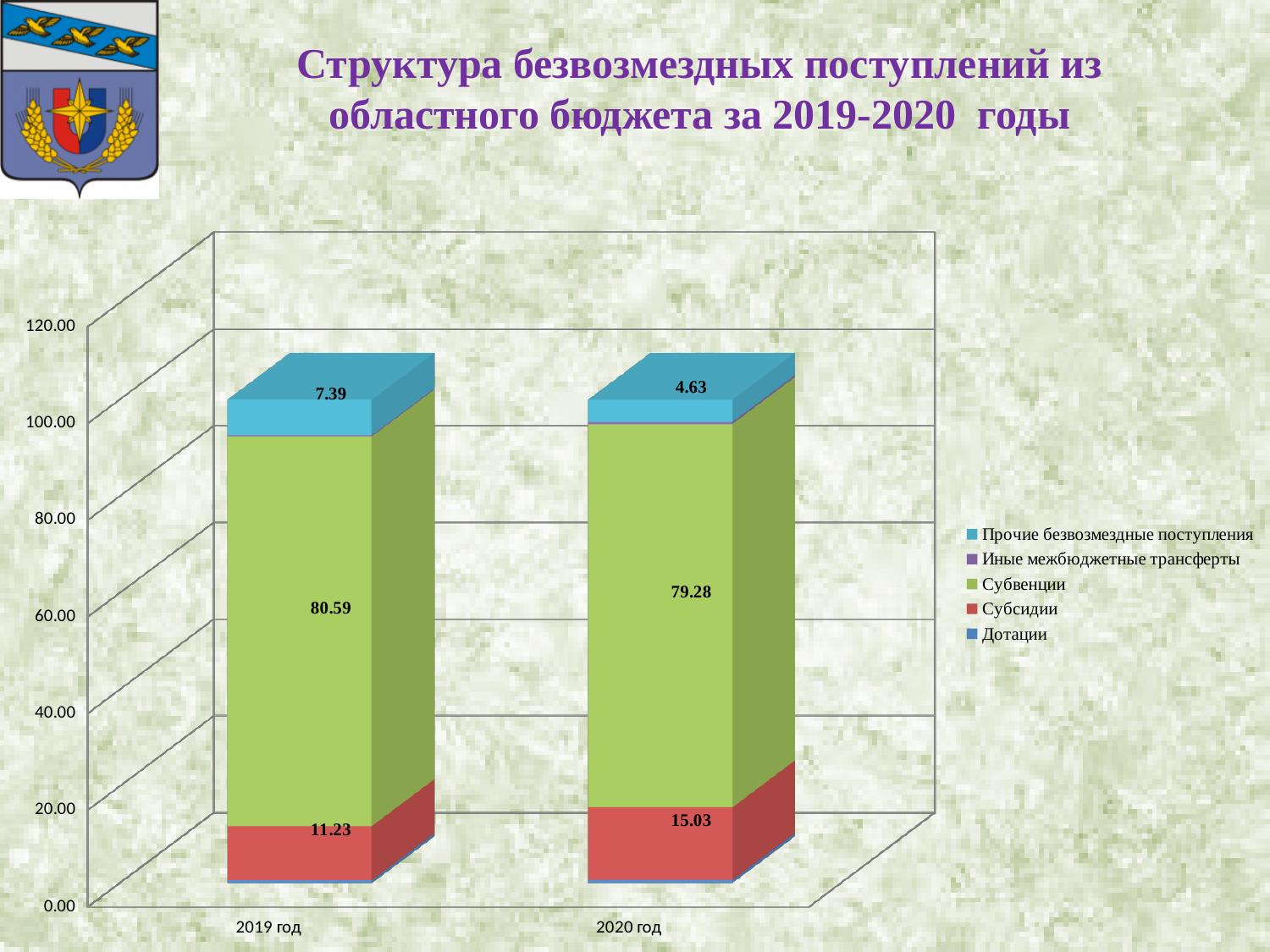
How many series does the legend list? 5 What is the value of Прочие безвозмездные поступления for 2019 год? 7.39 What kind of chart is shown on the slide? Stacked bar chart What is the value of Субсидии for 2019 год? 11.23 What is the value of Субвенции for 2019 год? 80.59 By how much did the value of Субсидии change from 2019 год to 2020 год? 3.80 What is the value of Субсидии for 2020 год? 15.03 What is the value of Субвенции for 2020 год? 79.28 Which series has the largest segment in the 2020 год bar? Субвенции Which year has the larger value for Прочие безвозмездные поступления, 2019 год or 2020 год? 2019 год What is the difference between the Субвенции values for 2019 год and 2020 год? 1.31 What is the value of Прочие безвозмездные поступления for 2020 год? 4.63